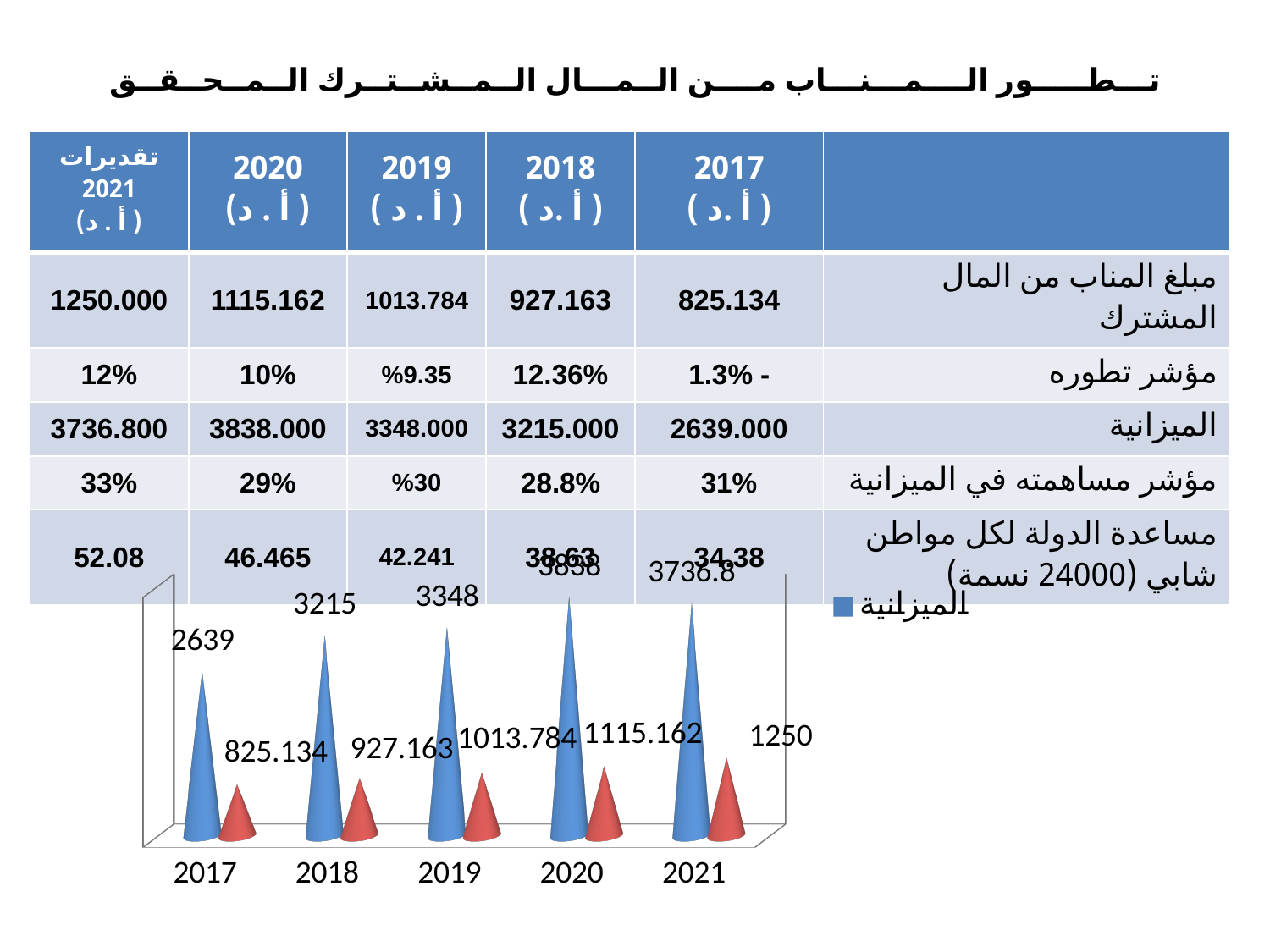
Which series name is readable in the chart's legend? الميزانية What is the value of the blue series for 2017 in the chart? 2639 What is the value of the blue series for 2021 in the chart? 3736.8 Does the red series rise or fall from 2017 to 2021 in the chart? rises In the chart, is the blue series value larger in 2019 or in 2018? 2019 What is the difference between the red series values for 2021 and 2020 in the chart? 134.838 In which year is the red series lowest in the chart? 2017 What is the difference between the blue series values for 2018 and 2017 in the chart? 576 How many years are shown on the x axis of the chart? 5 What is the value of the red series for 2021 in the chart? 1250 In which year does the blue series reach its highest value in the chart? 2020 What kind of chart is shown at the bottom of the slide? bar chart